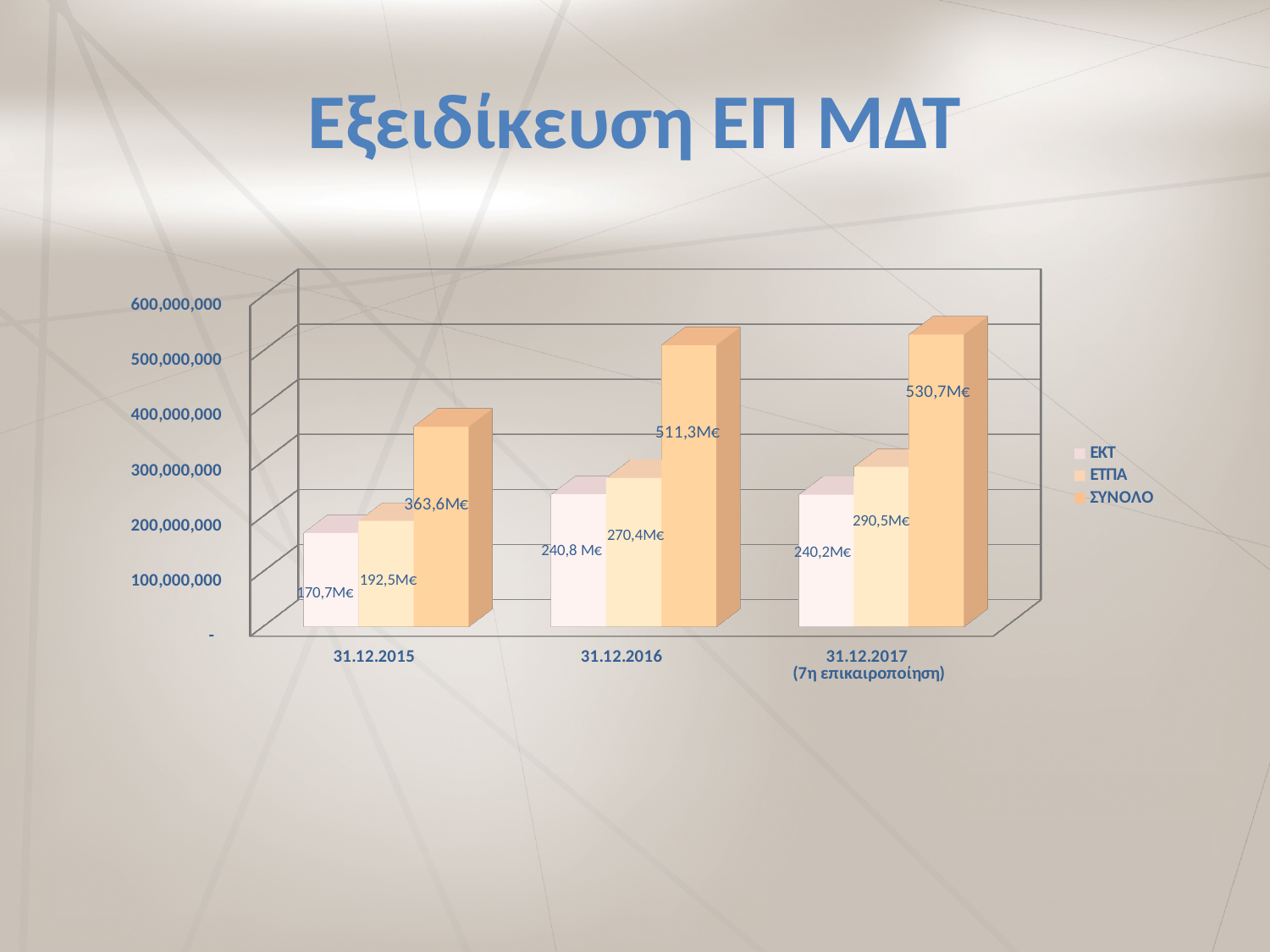
What is the ΕΤΠΑ value for 31.12.2016? 270,4Μ€ What kind of chart is shown on the slide? bar chart Which date has the highest ΣΥΝΟΛΟ value? 31.12.2017 (7η επικαιροποίηση) Which date has the lowest ΕΤΠΑ value? 31.12.2015 How many series does the legend list? 3 What is the ΕΤΠΑ value for 31.12.2017 (7η επικαιροποίηση)? 290,5Μ€ What is the ΕΚΤ value for 31.12.2015? 170,7Μ€ Does the ΣΥΝΟΛΟ value rise or fall from 31.12.2015 to 31.12.2017 (7η επικαιροποίηση)? rise What is the difference between the ΣΥΝΟΛΟ values for 31.12.2017 (7η επικαιροποίηση) and 31.12.2016? 19,4Μ€ What is the ΣΥΝΟΛΟ value for 31.12.2016? 511,3Μ€ Which is larger for 31.12.2015: the ΕΚΤ value or the ΕΤΠΑ value? ΕΤΠΑ Is the ΣΥΝΟΛΟ value for 31.12.2016 greater or less than 500,000,000? greater